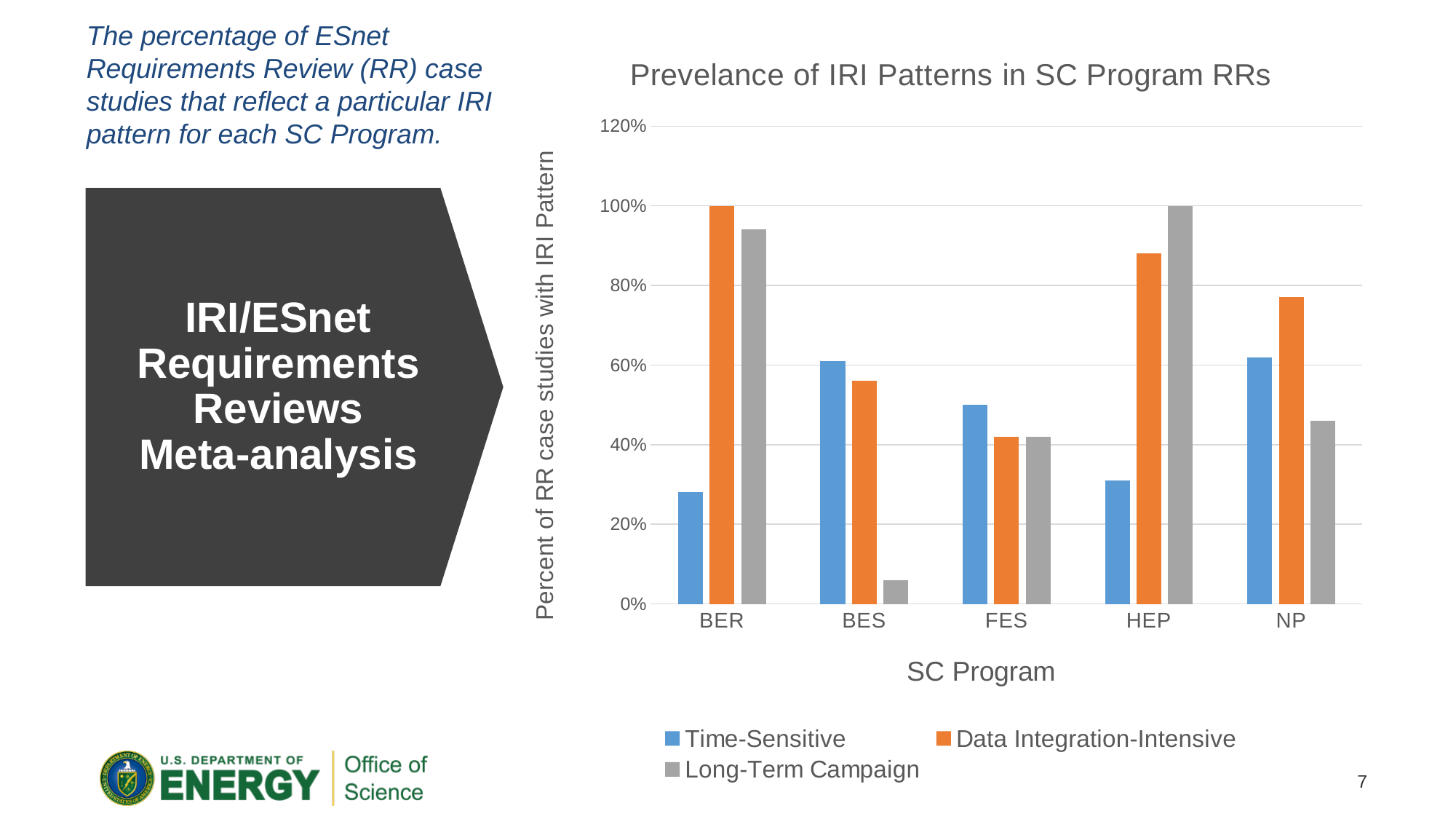
Is the Time-Sensitive value for HEP greater or less than 40%? less How many SC Programs are shown on the x axis of the chart? 5 How many series does the chart's legend list? 3 For BES, which is larger: the Time-Sensitive value or the Long-Term Campaign value? Time-Sensitive What is the title of the chart? Prevelance of IRI Patterns in SC Program RRs Which SC Program has the highest Time-Sensitive value? NP What is the Long-Term Campaign value for HEP? 100% Is the Data Integration-Intensive value for NP greater or less than 60%? greater Which SC Program has the lowest Long-Term Campaign value? BES What is the Data Integration-Intensive value for BER? 100% What kind of chart is shown on the slide? bar chart Which SC Program has the lowest Time-Sensitive value? BER